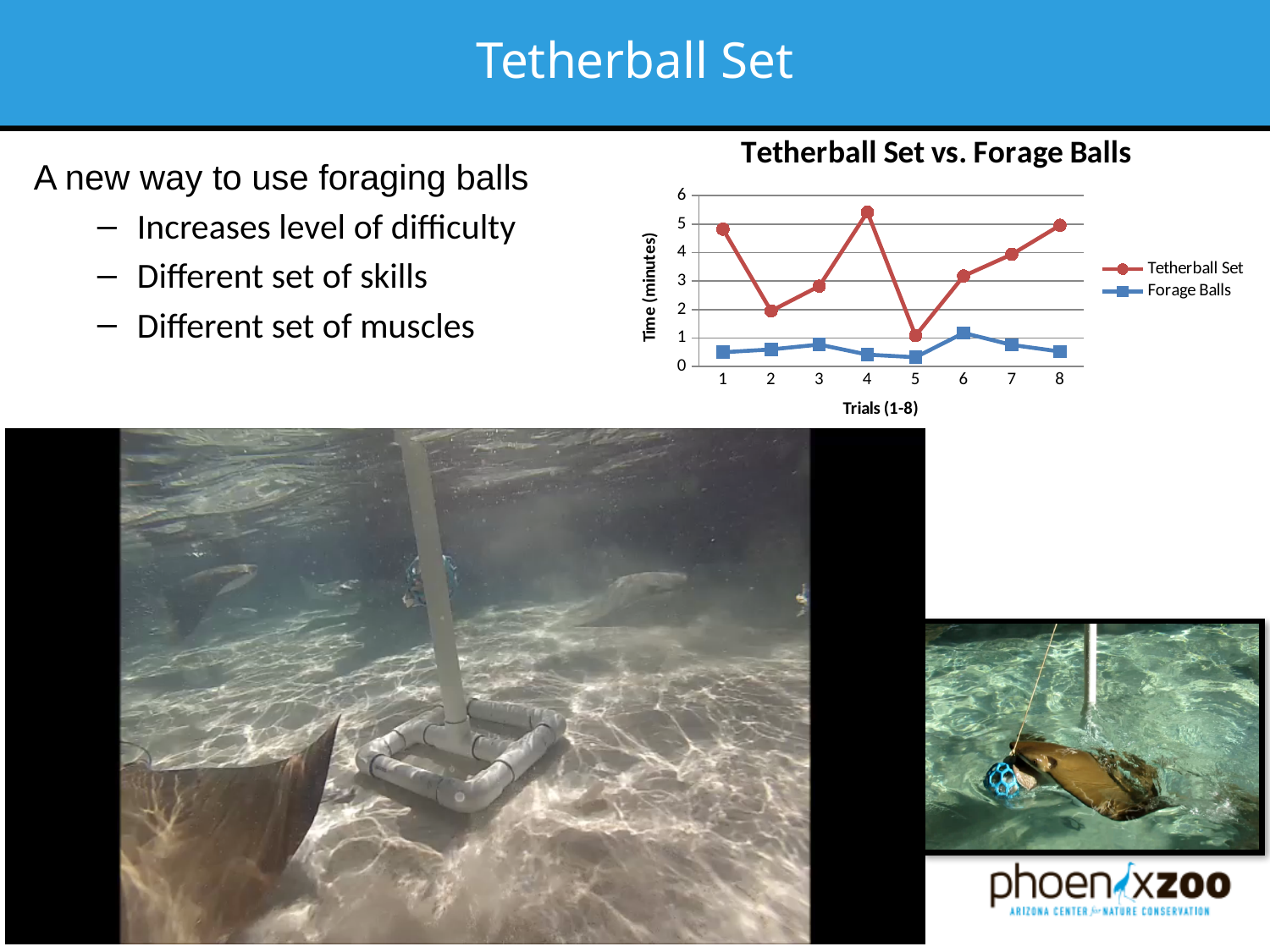
Is the Forage Balls value at trial 6 greater or less than 1? greater Is the Tetherball Set value at trial 1 greater or less than 4? greater At trial 4, which series has the larger value, Tetherball Set or Forage Balls? Tetherball Set At which trial does the Tetherball Set series reach its lowest value? 5 Does the Tetherball Set series rise or fall from trial 5 to trial 8? rise At which trial does the Forage Balls series reach its highest value? 6 What type of chart is shown on the slide? line chart At which trial does the Tetherball Set series reach its highest value? 4 How many series does the legend of the chart list? 2 Is the Tetherball Set value at trial 4 greater or less than 5? greater How many trials are plotted along the x axis of the chart? 8